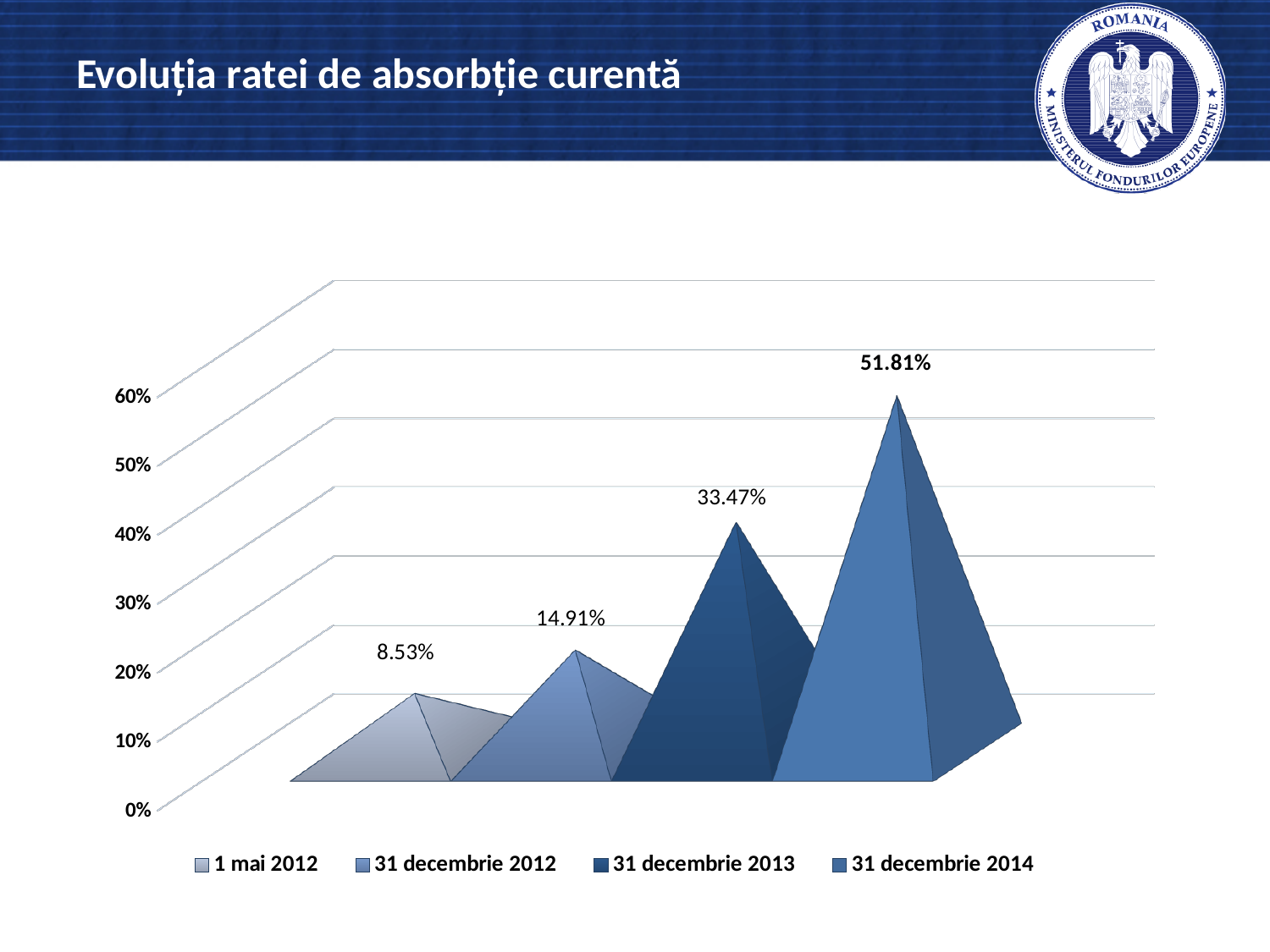
Which is larger, the value for 31 decembrie 2013 or the value for 31 decembrie 2012? 31 decembrie 2013 What is the value for 1 mai 2012? 8.53% What is the value for 31 decembrie 2014? 51.81% Do the values rise or fall from 1 mai 2012 to 31 decembrie 2014? rise What is the value for 31 decembrie 2012? 14.91% What is the difference between the values for 31 decembrie 2014 and 31 decembrie 2013? 18.34% What is the title of the chart slide? Evoluția ratei de absorbție curentă What is the value for 31 decembrie 2013? 33.47% What is the difference between the values for 31 decembrie 2012 and 1 mai 2012? 6.38% Which date has the lowest absorption rate? 1 mai 2012 How many series does the legend list? 4 Which date has the highest absorption rate? 31 decembrie 2014